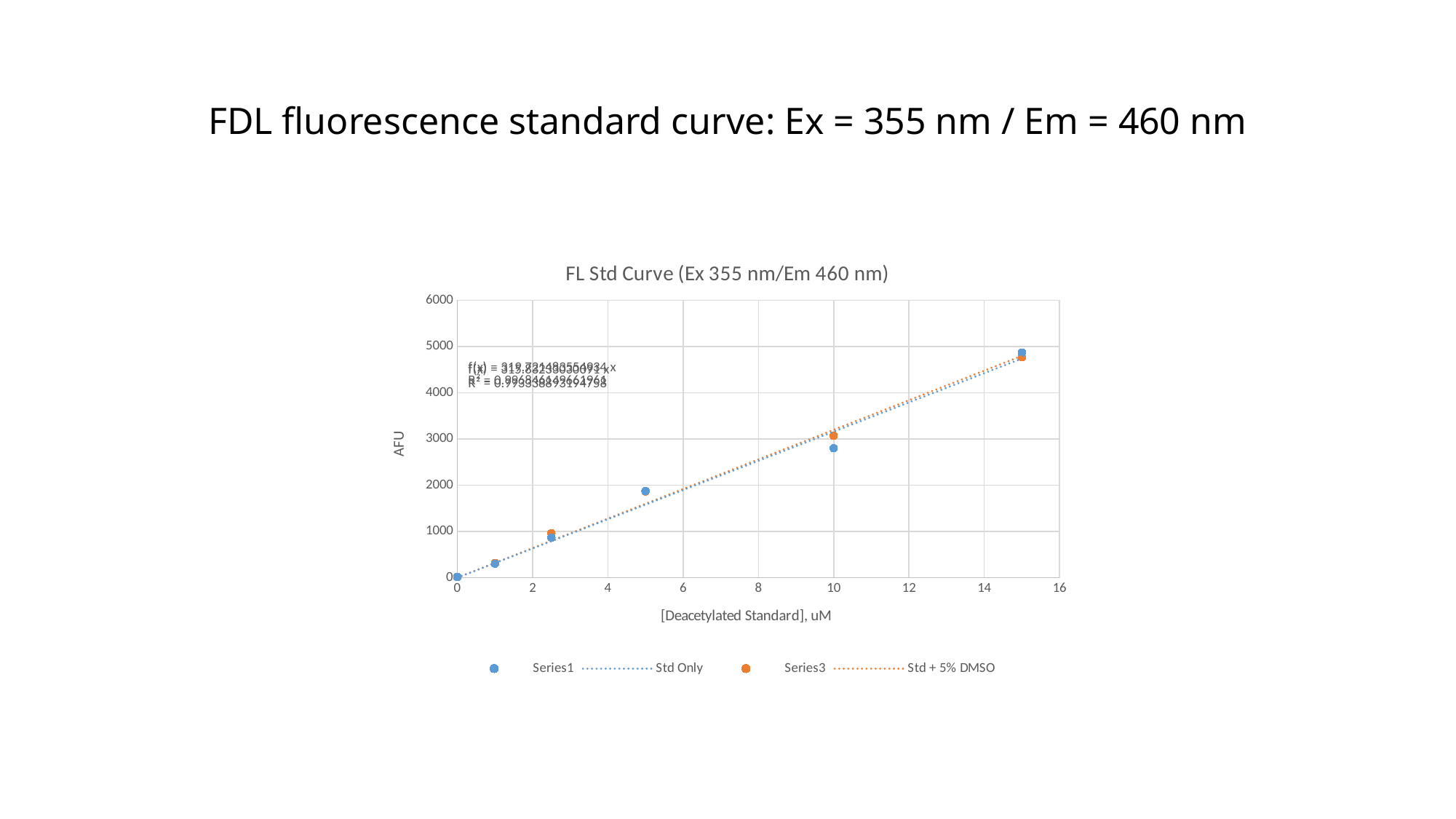
What is the title of the chart? FL Std Curve (Ex 355 nm/Em 460 nm) What kind of chart is shown on the slide? scatter chart Is the Series1 value at 15 uM greater or less than 4000? greater Is the Series1 value at 5 uM greater or less than 2000? less At 10 uM, which series has the higher AFU value, Series1 or Series3? Series3 How many data points are plotted for Series1? 6 Is the Series1 value at 10 uM greater or less than 3000? less Do the AFU values rise or fall as the deacetylated standard concentration increases? rise How many entries does the legend list? 4 At which concentration on the x axis is the AFU value highest? 15 At which concentration on the x axis is the AFU value lowest? 0 What is the label of the y axis? AFU